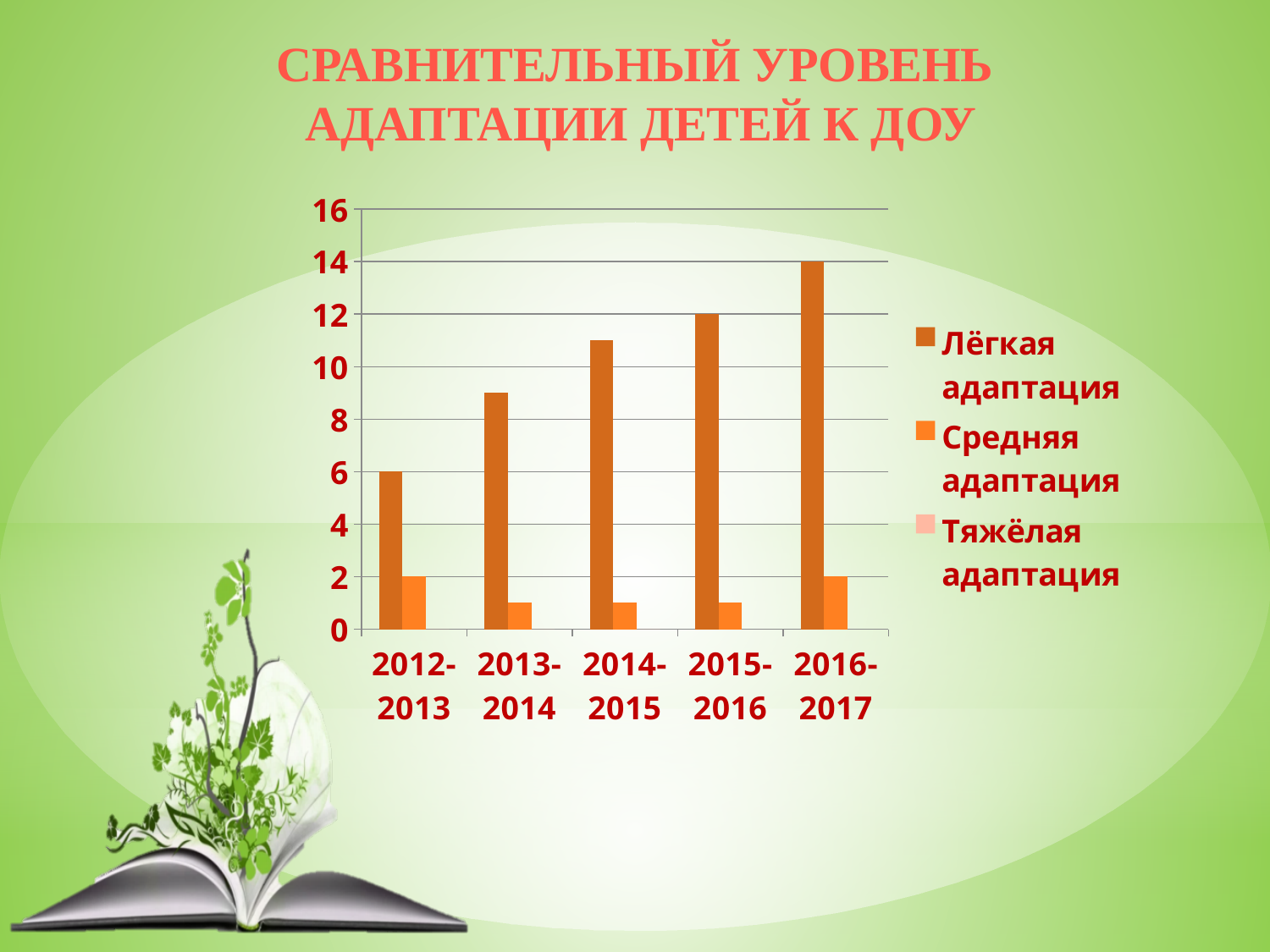
What is the difference between the Лёгкая адаптация values for 2016-2017 and 2012-2013? 8 Which year has the highest value for Лёгкая адаптация? 2016-2017 How many series does the legend list? 3 Do the values for Лёгкая адаптация rise or fall from 2012-2013 to 2016-2017? Rise Which year has the lowest value for Лёгкая адаптация? 2012-2013 What kind of chart is shown on the slide? Bar chart What is the value of Средняя адаптация for 2012-2013? 2 What is the value of Лёгкая адаптация for 2015-2016? 12 How many year categories are shown on the x axis? 5 What is the value of Лёгкая адаптация for 2016-2017? 14 What is the value of Лёгкая адаптация for 2012-2013? 6 Is the value of Лёгкая адаптация for 2013-2014 greater or less than 8? greater